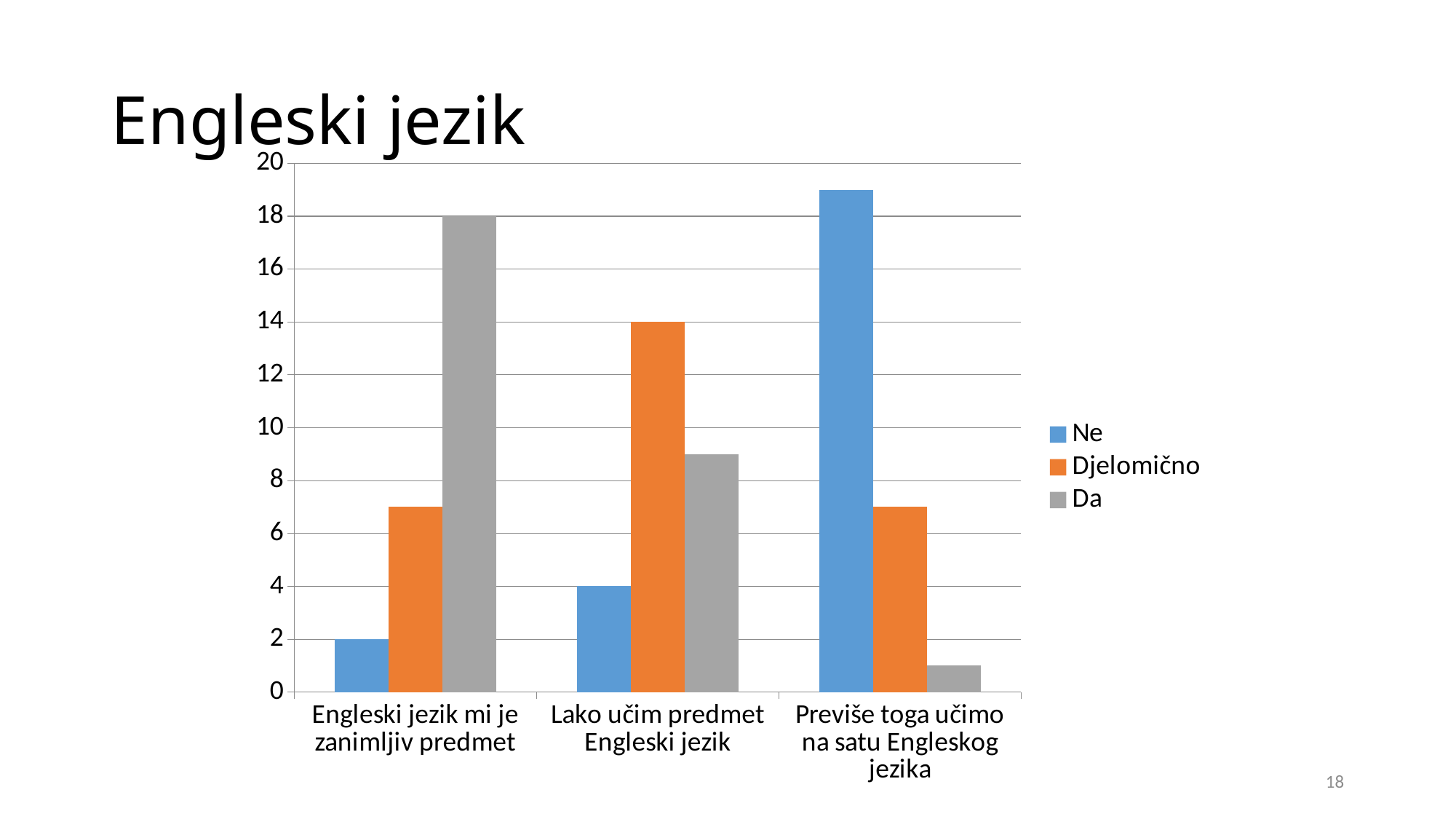
What kind of chart is shown on the slide? bar chart How many series does the legend list? 3 What is the value of 'Ne' for 'Lako učim predmet Engleski jezik'? 4 Is the value of 'Da' for 'Previše toga učimo na satu Engleskog jezika' greater or less than 2? less What is the difference between 'Da' and 'Ne' for 'Engleski jezik mi je zanimljiv predmet'? 16 Which series has the highest value for 'Lako učim predmet Engleski jezik'? Djelomično Which series has the lowest value for 'Previše toga učimo na satu Engleskog jezika'? Da What is the value of 'Ne' for 'Engleski jezik mi je zanimljiv predmet'? 2 What is the value of 'Da' for 'Engleski jezik mi je zanimljiv predmet'? 18 Is the value of 'Ne' for 'Previše toga učimo na satu Engleskog jezika' greater or less than 18? greater What is the value of 'Djelomično' for 'Lako učim predmet Engleski jezik'? 14 How many categories are shown on the x axis? 3